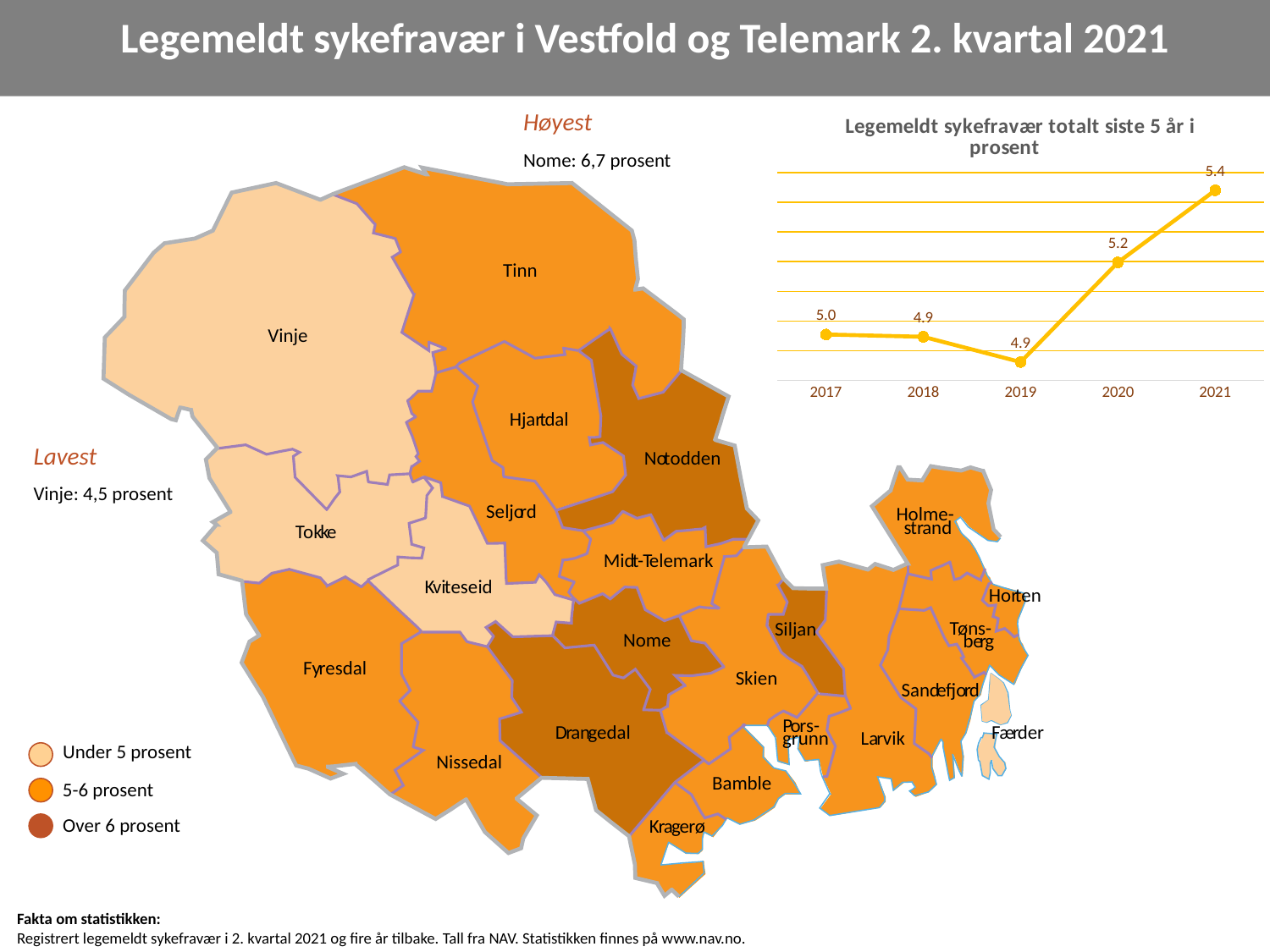
In the chart 'Legemeldt sykefravær totalt siste 5 år i prosent', what is the difference between the 2020 value and the 2017 value? 0.2 In the chart 'Legemeldt sykefravær totalt siste 5 år i prosent', which is larger, the value for 2017 or the value for 2020? 2020 In the chart 'Legemeldt sykefravær totalt siste 5 år i prosent', what is the value for 2020? 5.2 In the chart 'Legemeldt sykefravær totalt siste 5 år i prosent', what is the difference between the 2021 value and the 2019 value? 0.5 In the chart 'Legemeldt sykefravær totalt siste 5 år i prosent', what is the value for 2021? 5.4 In the chart 'Legemeldt sykefravær totalt siste 5 år i prosent', what is the value for 2017? 5.0 In the chart 'Legemeldt sykefravær totalt siste 5 år i prosent', what is the value for 2018? 4.9 In the chart 'Legemeldt sykefravær totalt siste 5 år i prosent', do the values rise or fall from 2019 to 2021? Rise In the chart 'Legemeldt sykefravær totalt siste 5 år i prosent', which year has the highest value? 2021 What kind of chart is 'Legemeldt sykefravær totalt siste 5 år i prosent'? Line chart How many years are plotted in the chart 'Legemeldt sykefravær totalt siste 5 år i prosent'? 5 According to the map on the slide, which municipality has the lowest sick leave rate, and what is it? Vinje: 4,5 prosent